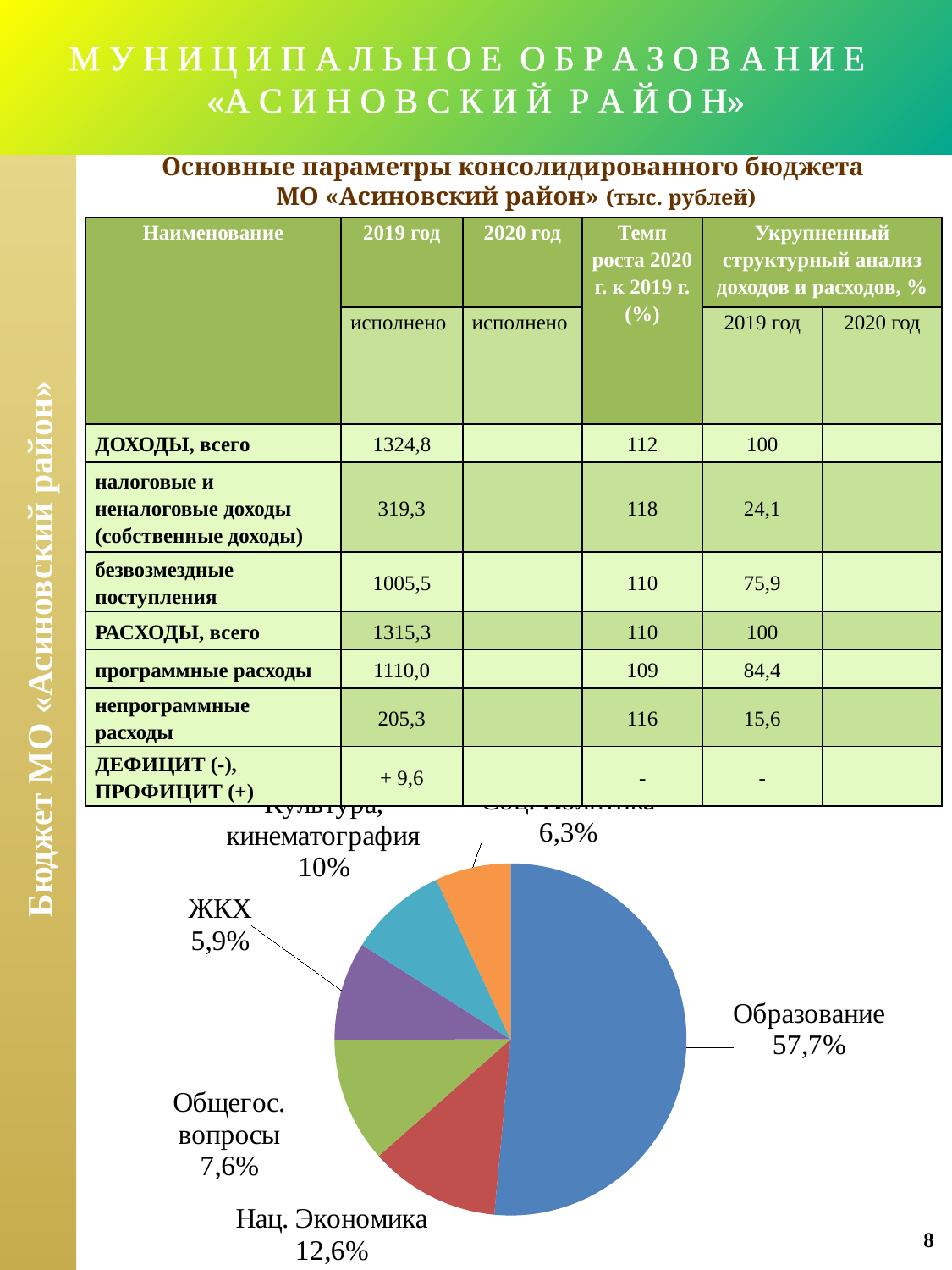
In the pie chart, what is the difference between the shares of Образование and Нац. Экономика? 45,1% In the pie chart, what share does Культура, кинематография have? 10% Which slice of the pie chart is the largest? Образование In the pie chart, which is larger: Нац. Экономика or Общегос. вопросы? Нац. Экономика What kind of chart is shown at the bottom of the slide? pie chart In the pie chart, what share does Образование have? 57,7% How many slices does the pie chart have? 6 In the pie chart, what share does Нац. Экономика have? 12,6% In the pie chart, what share does Общегос. вопросы have? 7,6% What colour is the Образование slice in the pie chart? blue In the pie chart, what share does ЖКХ have? 5,9%